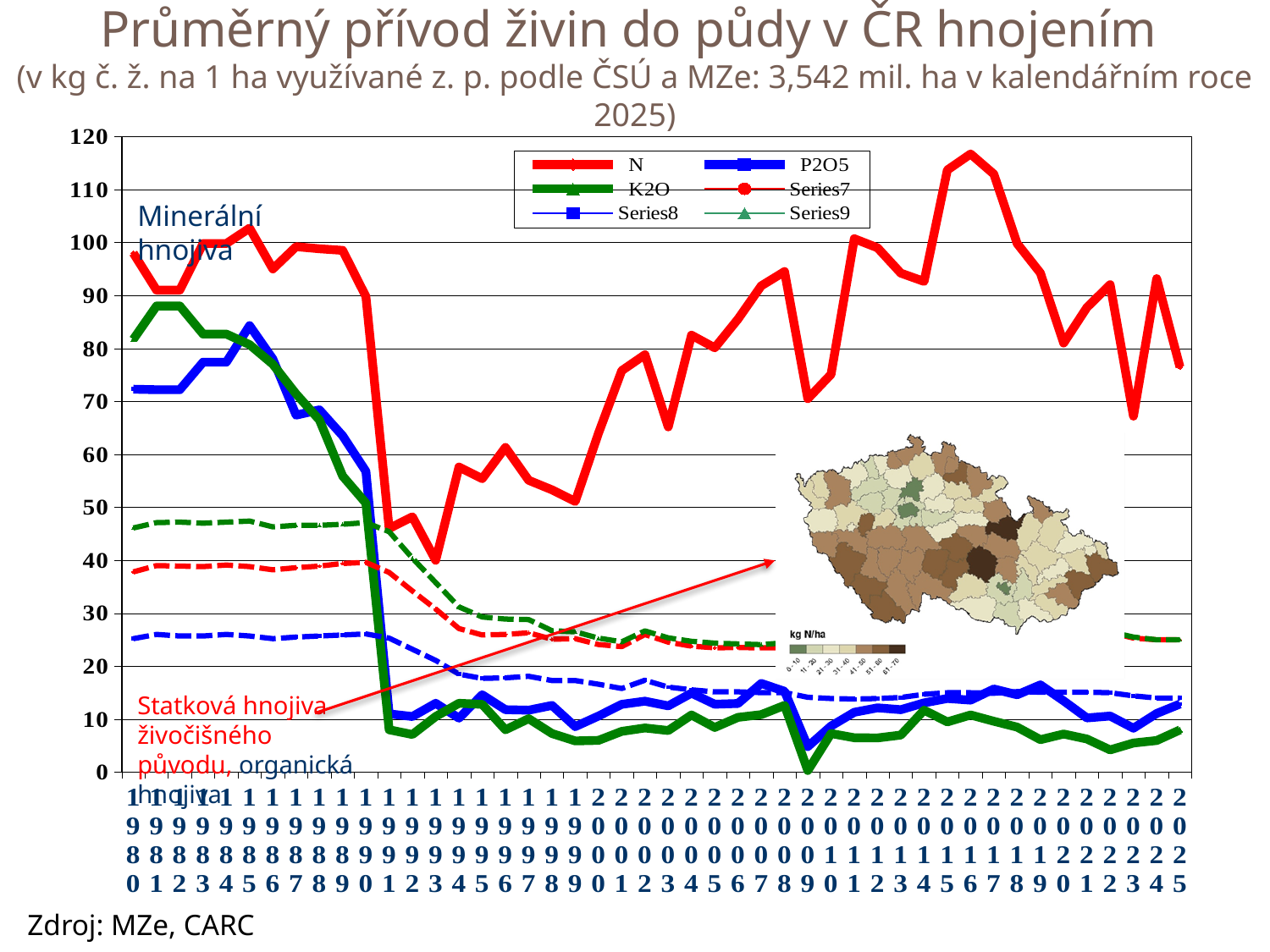
Does the value for K2O rise or fall between 1985 and 1991? fall Is the value for N in 1991 greater or less than 60? less Is the value for Series9 in 1980 greater or less than 40? greater Is the value for N in 1980 greater or less than 90? greater What kind of chart is shown on the slide? line chart What source is cited below the chart? Zdroj: MZe, CARC In 1980, which is larger: the value for N or the value for K2O? N How many series does the chart legend list? 6 Which series has the highest value in 2016? N